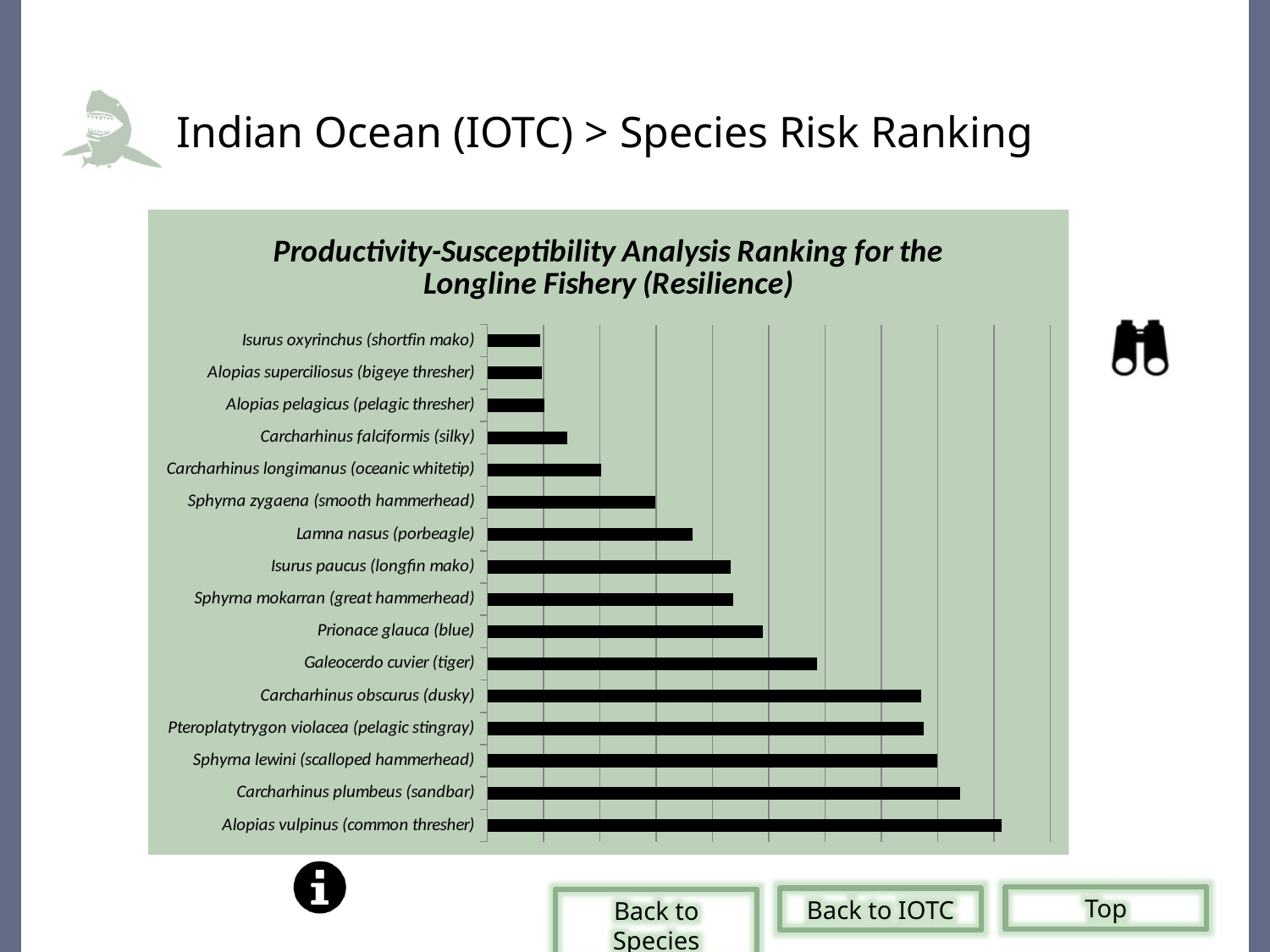
What is the title of the chart? Productivity-Susceptibility Analysis Ranking for the Longline Fishery (Resilience) Which has the longer bar, Isurus paucus (longfin mako) or Alopias pelagicus (pelagic thresher)? Isurus paucus (longfin mako) Which has the longer bar, Galeocerdo cuvier (tiger) or Prionace glauca (blue)? Galeocerdo cuvier (tiger) How many species are plotted in the chart? 16 Do the bar lengths generally increase or decrease going from the top species to the bottom species? Increase Which has the longer bar, Carcharhinus falciformis (silky) or Carcharhinus longimanus (oceanic whitetip)? Carcharhinus longimanus (oceanic whitetip) Which species has the longest bar in the chart? Alopias vulpinus (common thresher) Which species is listed at the top of the chart? Isurus oxyrinchus (shortfin mako) What colour are the bars in the chart? Black What kind of chart is shown on the slide? Bar chart